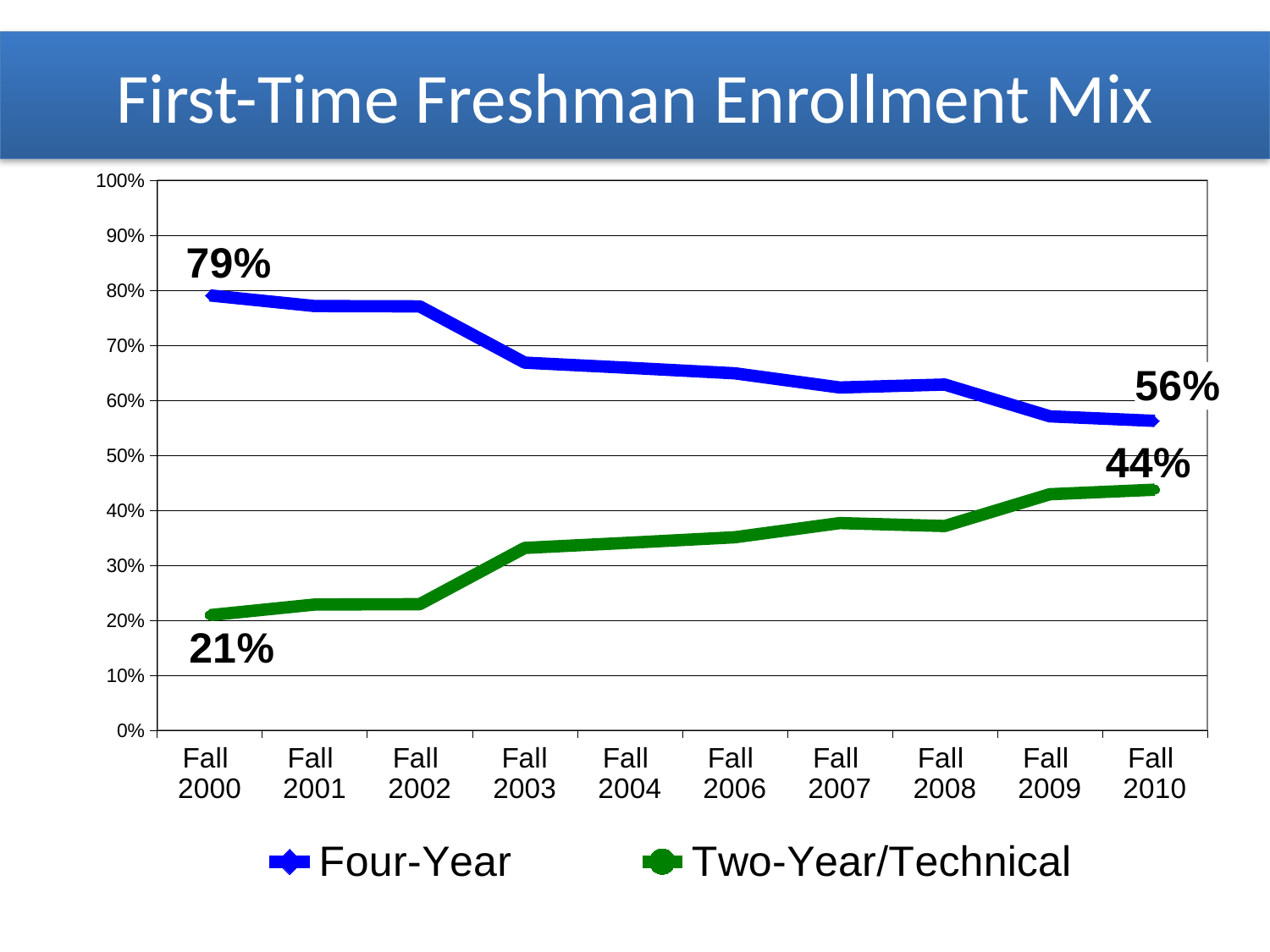
What kind of chart is shown? Line chart Is the Four-Year value for Fall 2003 greater or less than 70%? less What is the Four-Year value for Fall 2010? 56% What is the Two-Year/Technical value for Fall 2000? 21% Is the Two-Year/Technical value for Fall 2007 greater or less than 30%? greater What is the Four-Year value for Fall 2000? 79% What is the Two-Year/Technical value for Fall 2010? 44% What is the difference between the Four-Year and Two-Year/Technical values in Fall 2010? 12 Does the Two-Year/Technical series rise or fall from Fall 2000 to Fall 2010? Rise By how many percentage points did the Four-Year share fall from Fall 2000 to Fall 2010? 23 How many series does the legend list? 2